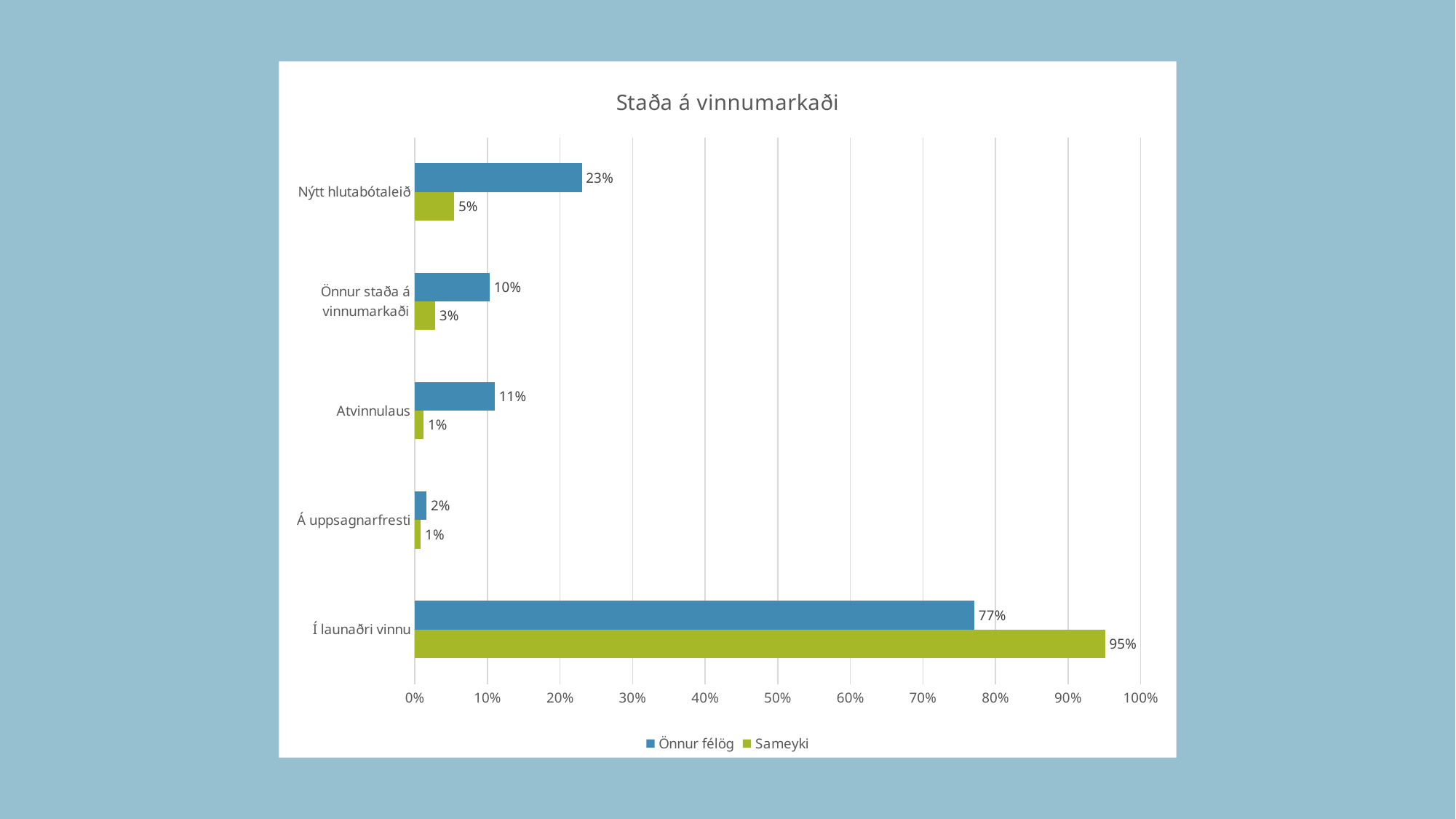
How many series does the legend list? 2 Is the value for Önnur félög in the Í launaðri vinnu category greater or less than 80%? less What is the difference between Sameyki and Önnur félög in the Í launaðri vinnu category? 18% Which category has the lowest value for Önnur félög? Á uppsagnarfresti What is the value for Önnur félög in the Nýtt hlutabótaleið category? 23% What type of chart is shown on the slide? Bar chart What is the value for Sameyki in the Í launaðri vinnu category? 95% Which series has the larger value in the Nýtt hlutabótaleið category, Önnur félög or Sameyki? Önnur félög What is the value for Önnur félög in the Önnur staða á vinnumarkaði category? 10% How many categories are shown on the chart? 5 Which category has the highest value for Önnur félög? Í launaðri vinnu What is the value for Sameyki in the Atvinnulaus category? 1%